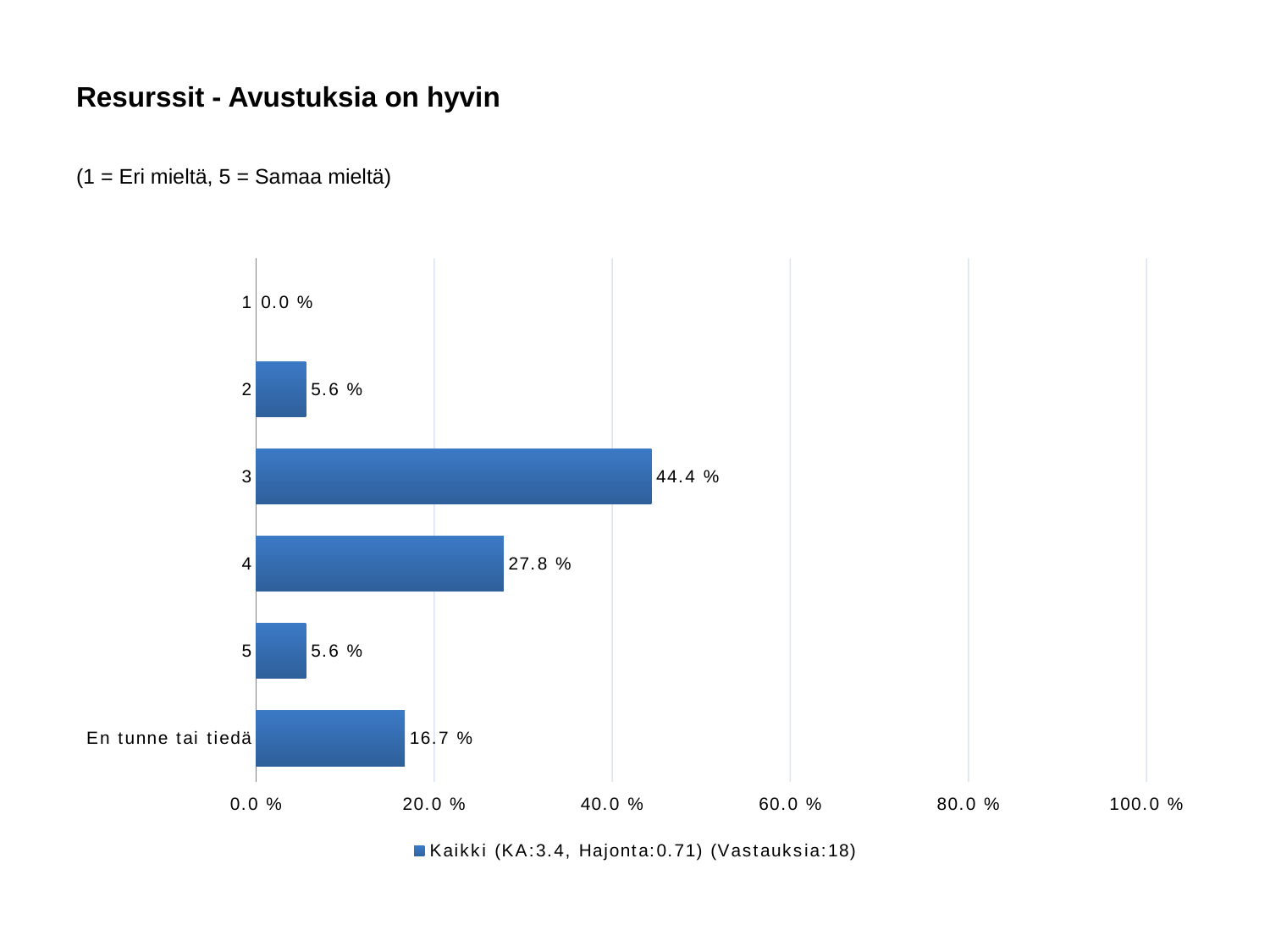
Which is larger, the value for category 4 or the value for "En tunne tai tiedä"? 4 Is the value for category 3 greater or less than 40.0 %? greater What is the value for category 1? 0.0 % What kind of chart is shown on the slide? bar chart How many responses (Vastauksia) does the legend report? 18 Which category has the highest value? 3 What is the value for "En tunne tai tiedä"? 16.7 % What is the difference between the values for category 3 and category 4? 16.6 % What is the value for category 3? 44.4 % Which category has the lowest value? 1 How many categories are shown on the chart? 6 What is the value for category 4? 27.8 %